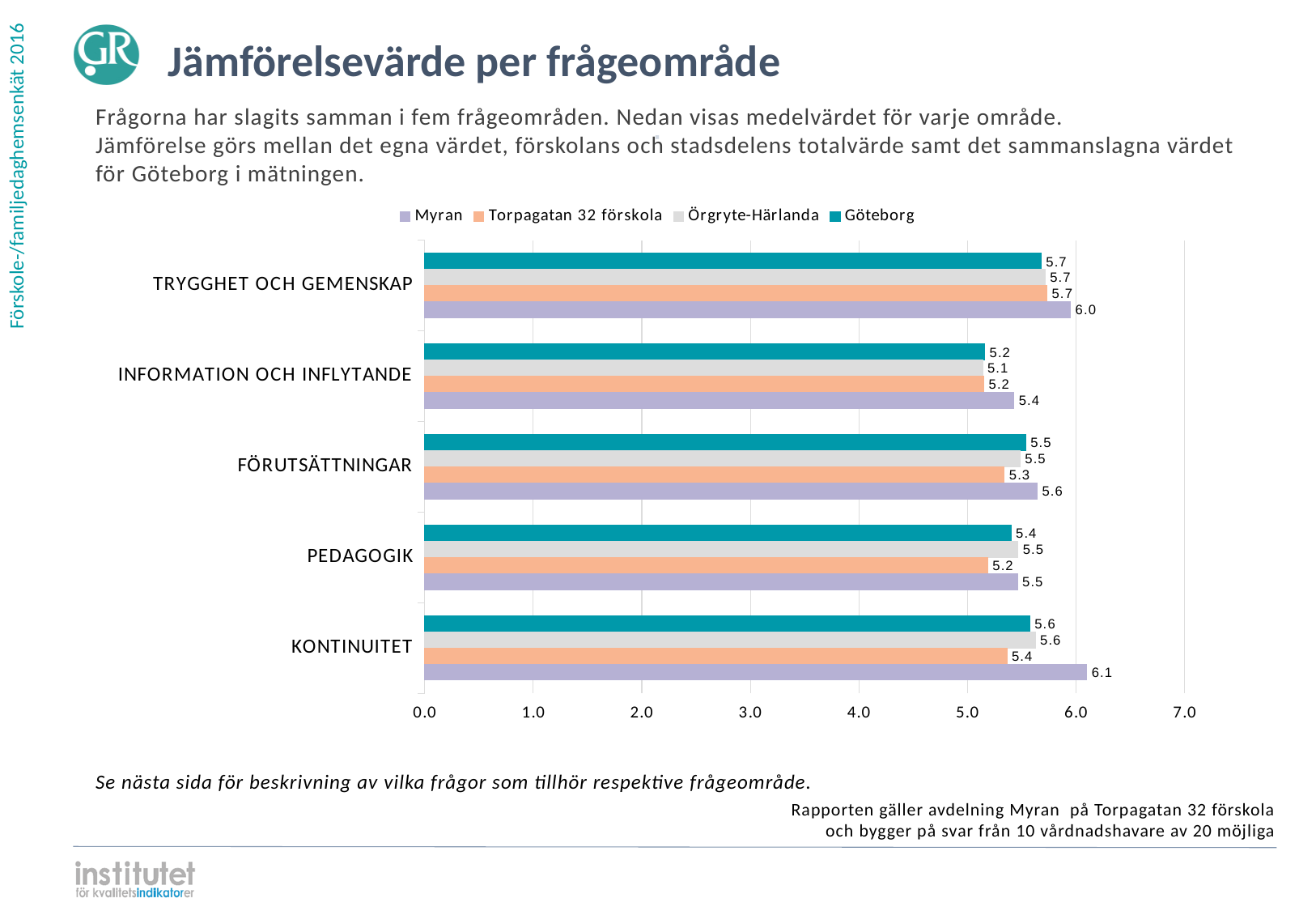
How many categories are shown on the y axis of the chart? 5 In the TRYGGHET OCH GEMENSKAP category, which is larger: the value for Myran or the value for Göteborg? Myran How many series does the legend list? 4 What is the value for Göteborg in the INFORMATION OCH INFLYTANDE category? 5.2 In which category does Myran have its highest value? KONTINUITET What is the value for Myran in the KONTINUITET category? 6.1 What is the difference between the Myran value and the Torpagatan 32 förskola value in the KONTINUITET category? 0.7 Is the value for Myran in the TRYGGHET OCH GEMENSKAP category greater or less than 5.0? greater What is the value for Torpagatan 32 förskola in the FÖRUTSÄTTNINGAR category? 5.3 In which category does Torpagatan 32 förskola have its lowest value? PEDAGOGIK What kind of chart is shown on the slide? Bar chart What is the value for Örgryte-Härlanda in the PEDAGOGIK category? 5.5